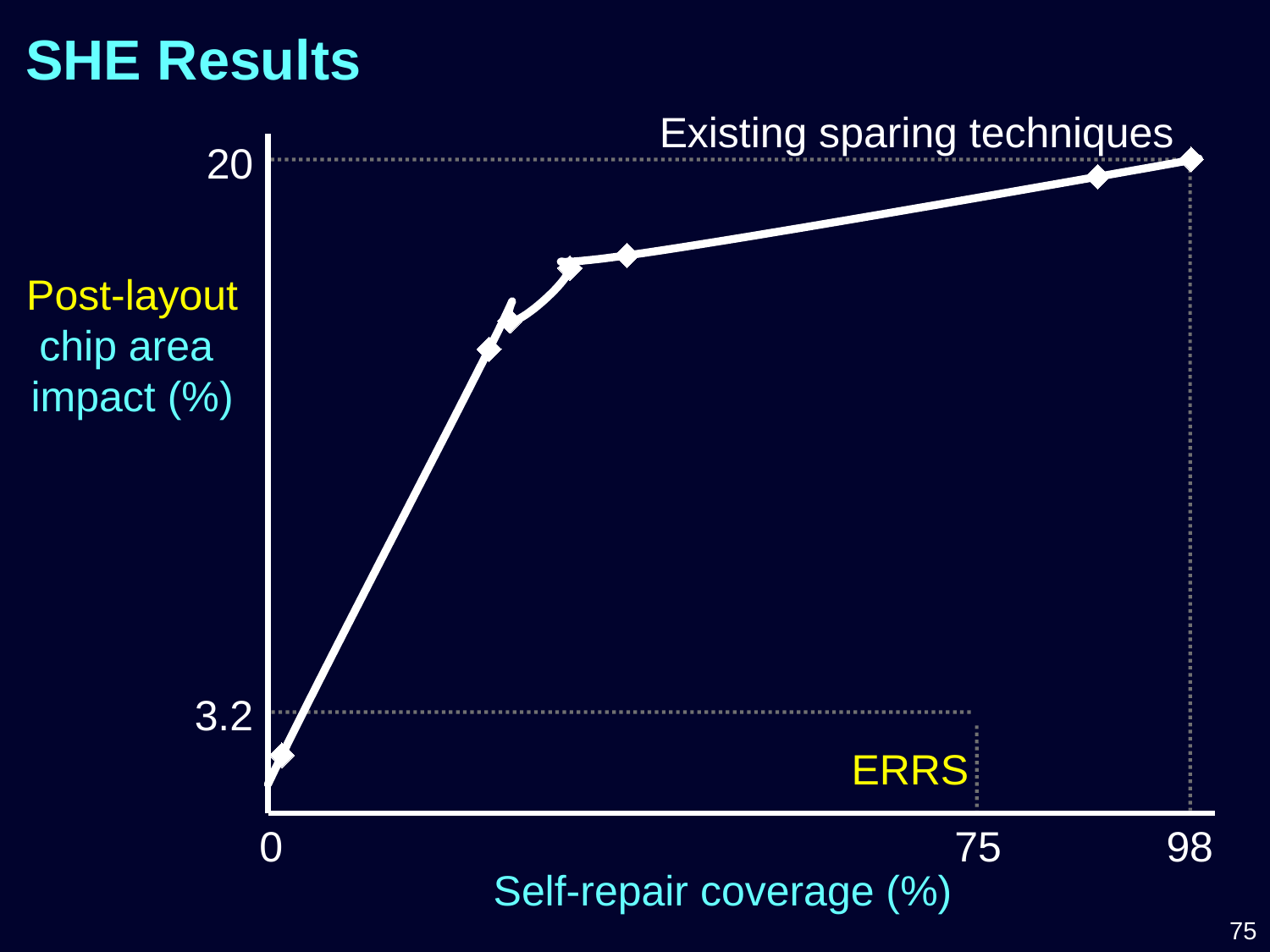
What kind of chart is shown on the slide? Line chart Is the post-layout chip area impact at a self-repair coverage of 0 greater or less than 3.2? less Does the post-layout chip area impact rise or fall as self-repair coverage increases? Rise What is the title of the slide containing the chart? SHE Results What is the label of the x axis? Self-repair coverage (%) What self-repair coverage (%) is marked for existing sparing techniques on the x axis? 98 Which has the higher post-layout chip area impact, ERRS or existing sparing techniques? Existing sparing techniques What is the difference in post-layout chip area impact (%) between existing sparing techniques and ERRS? 16.8 What post-layout chip area impact (%) is marked for ERRS on the y axis? 3.2 What is the label of the y axis? Post-layout chip area impact (%) What self-repair coverage (%) is marked for ERRS on the x axis? 75 What post-layout chip area impact (%) is marked for existing sparing techniques on the y axis? 20